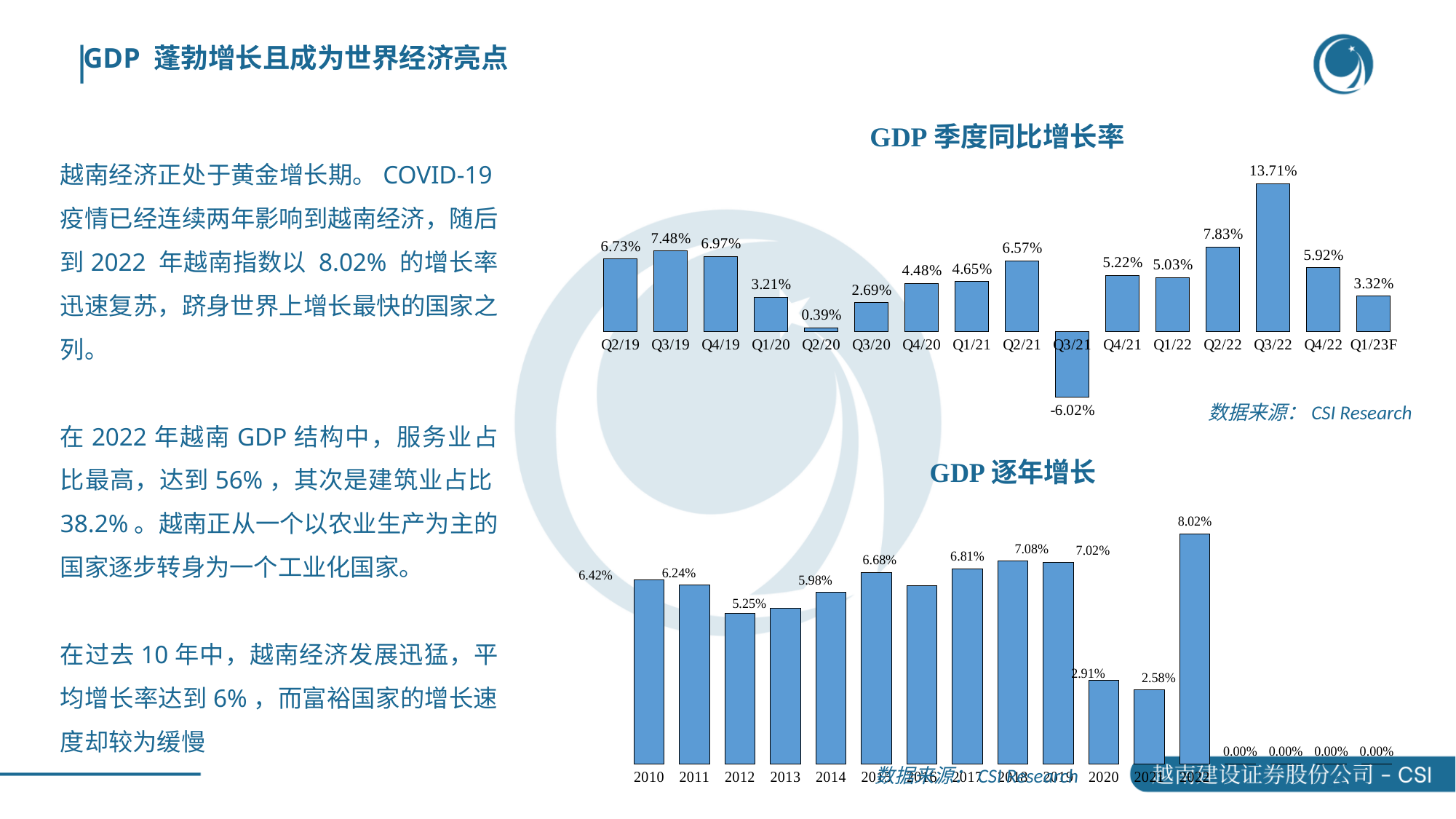
In the 'GDP 季度同比增长率' chart, what is the value for Q1/23F? 3.32% In the 'GDP 季度同比增长率' chart, which quarter has the lowest value? Q3/21 In the 'GDP 季度同比增长率' chart, which quarter has the highest growth rate? Q3/22 In the 'GDP 逐年增长' chart, what is the value for 2021? 2.58% What kind of chart is 'GDP 逐年增长'? bar chart In the 'GDP 季度同比增长率' chart, what is the difference between Q3/22 and Q2/22? 5.88% In the 'GDP 季度同比增长率' chart, what is the value for Q3/22? 13.71% In the 'GDP 逐年增长' chart, what is the value for 2022? 8.02% In the 'GDP 季度同比增长率' chart, what is the value for Q2/20? 0.39% In the 'GDP 季度同比增长率' chart, how many quarters are plotted? 16 In the 'GDP 逐年增长' chart, what is the difference between 2022 and 2021? 5.44% In the 'GDP 季度同比增长率' chart, which is larger, Q3/19 or Q4/19? Q3/19